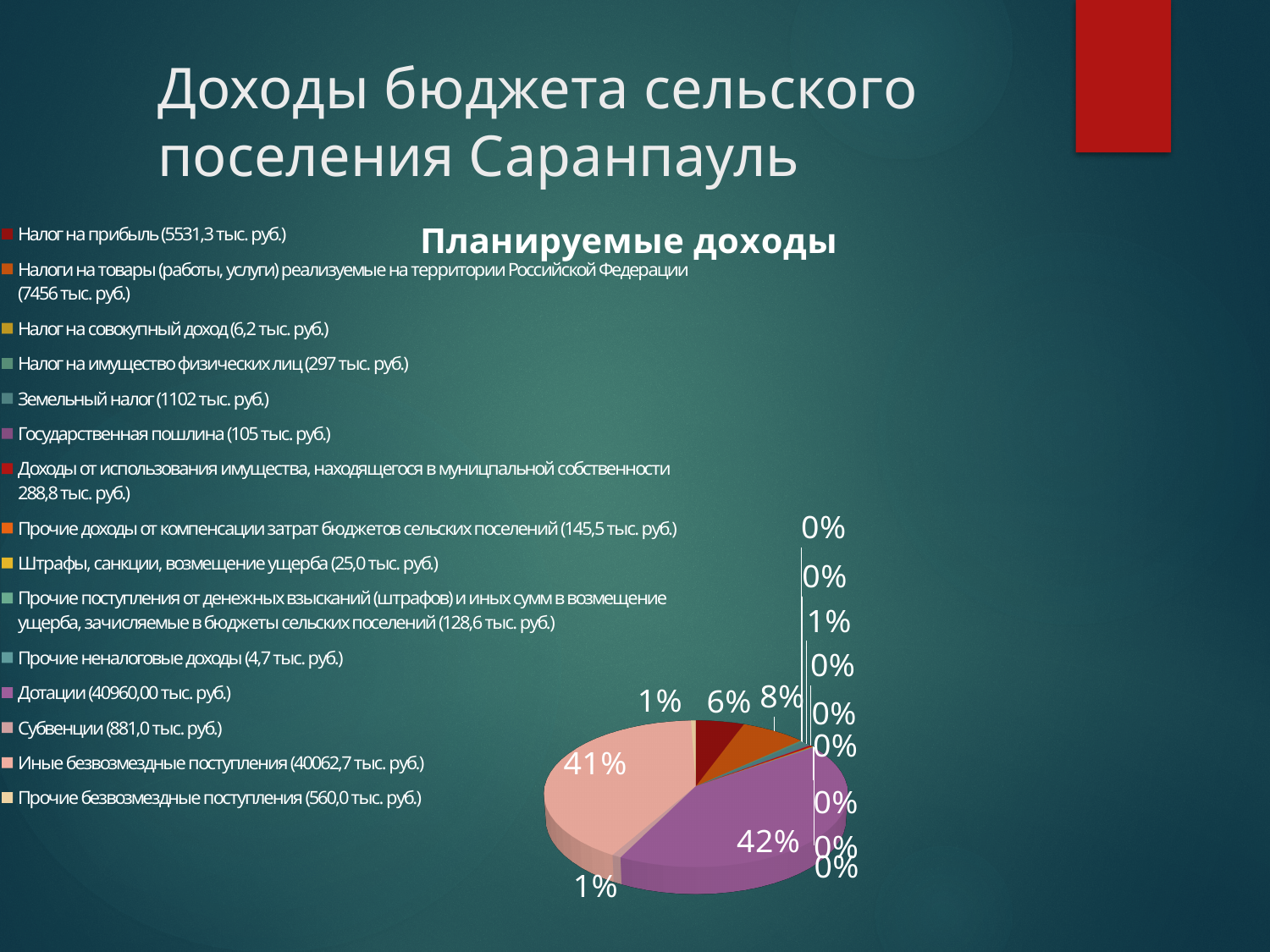
How many categories does the legend of the pie chart list? 15 What amount does the legend give for Земельный налог? 1102 тыс. руб. What share of the pie does Налог на прибыль account for? 6% What kind of chart is shown on the slide? Pie chart What share of the pie does Дотации account for? 42% What share of the pie does Иные безвозмездные поступления account for? 41% Which category has the largest share of the pie? Дотации What amount does the legend give for Дотации? 40960,00 тыс. руб. What is the title of the chart? Планируемые доходы Which is larger: the share for Дотации or the share for Иные безвозмездные поступления? Дотации By how many percentage points does the share for Дотации exceed the share for Иные безвозмездные поступления? 1